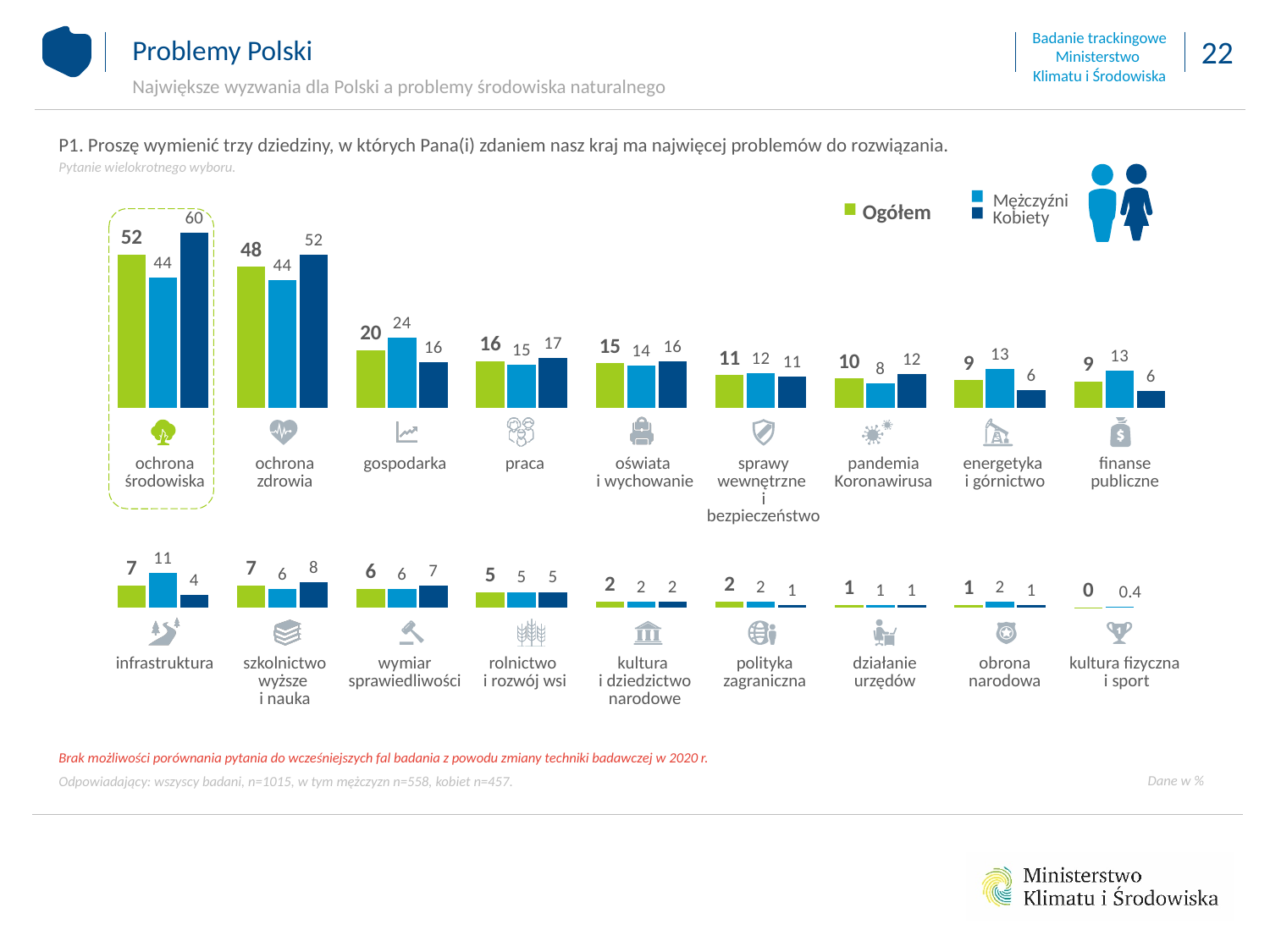
For pandemia Koronawirusa, which is larger: the Mężczyźni value or the Kobiety value? Kobiety For energetyka i górnictwo, which is larger: the Mężczyźni value or the Kobiety value? Mężczyźni How many series does the legend list? 3 What is the Mężczyźni value for infrastruktura? 11 How many categories are shown in the chart in total? 18 What is the difference between the Kobiety and Mężczyźni values for ochrona środowiska? 16 Which category has the highest Ogółem value? ochrona środowiska What is the Kobiety value for ochrona zdrowia? 52 Which category has the lowest Ogółem value? kultura fizyczna i sport What is the Mężczyźni value for gospodarka? 24 What kind of chart is shown on the slide? bar chart What is the Ogółem value for ochrona środowiska? 52